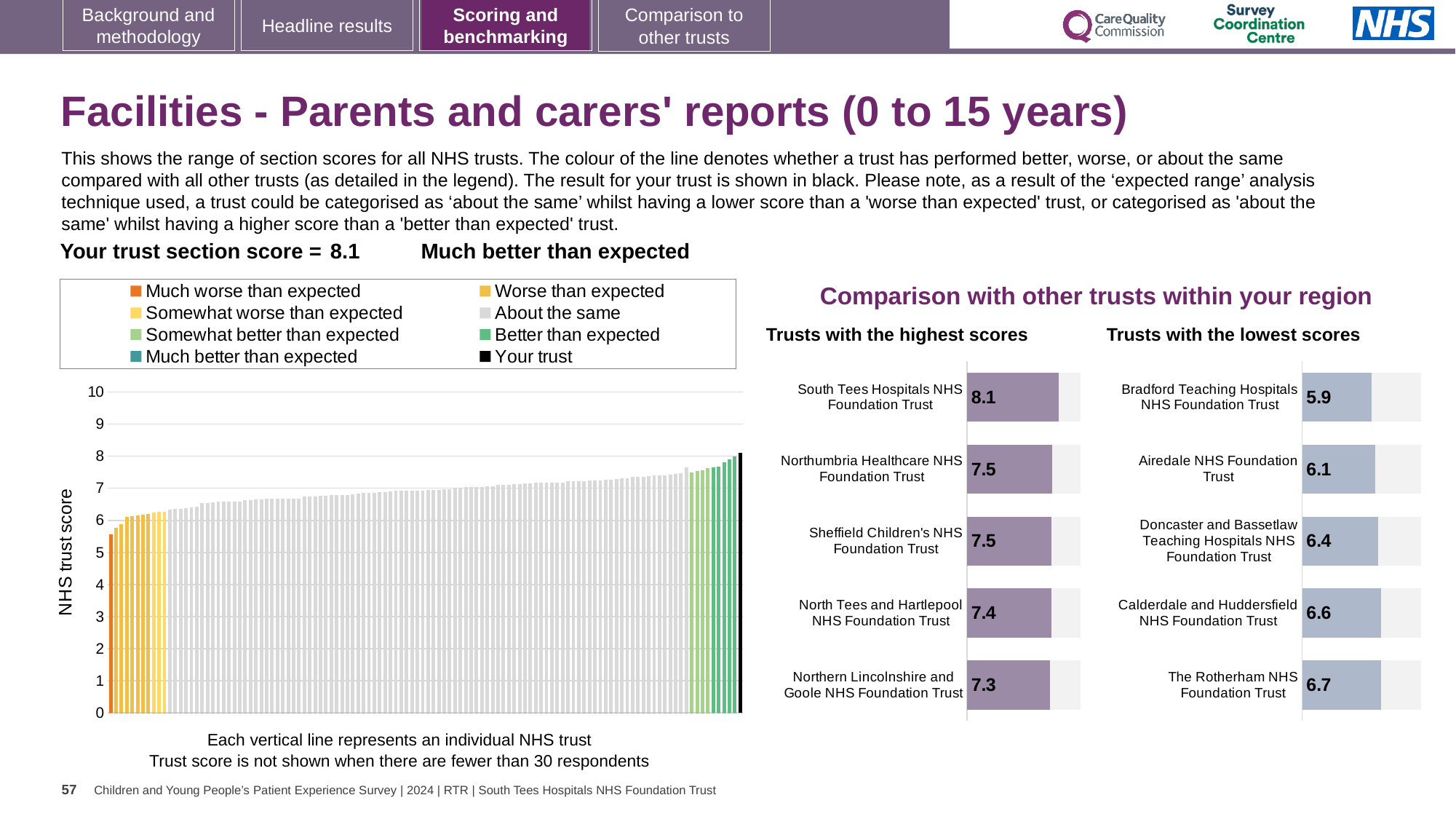
In the 'Trusts with the highest scores' chart, which trust has the lowest score shown? Northern Lincolnshire and Goole NHS Foundation Trust In the 'Trusts with the highest scores' chart, what is the score for North Tees and Hartlepool NHS Foundation Trust? 7.4 In the 'Trusts with the lowest scores' chart, which has the larger score: Airedale NHS Foundation Trust or Calderdale and Huddersfield NHS Foundation Trust? Calderdale and Huddersfield NHS Foundation Trust In the 'Trusts with the lowest scores' chart, what is the score for Doncaster and Bassetlaw Teaching Hospitals NHS Foundation Trust? 6.4 In the 'Trusts with the highest scores' chart, what is the score for South Tees Hospitals NHS Foundation Trust? 8.1 In the main chart on the left, is the value for the black 'Your trust' bar greater or less than 7? greater In the 'Trusts with the lowest scores' chart, what is the score for Bradford Teaching Hospitals NHS Foundation Trust? 5.9 In the 'Trusts with the highest scores' chart, what is the difference between the scores of South Tees Hospitals NHS Foundation Trust and Northern Lincolnshire and Goole NHS Foundation Trust? 0.8 What kind of chart is the main chart on the left showing all NHS trusts? Bar chart How many trusts are listed in the 'Trusts with the lowest scores' chart? 5 In the 'Trusts with the lowest scores' chart, which trust has the highest score shown? The Rotherham NHS Foundation Trust How many entries does the legend of the main chart on the left list? 8